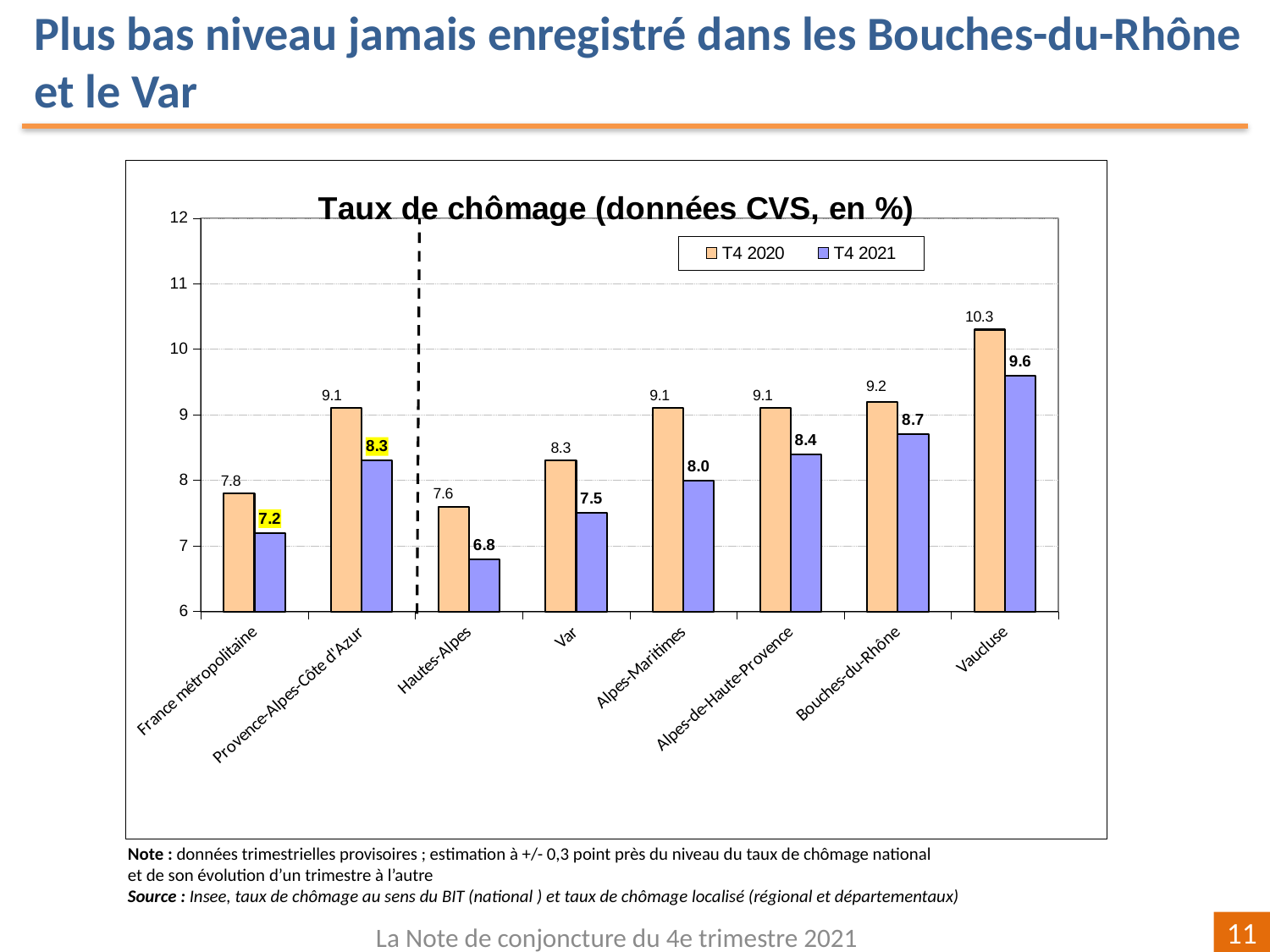
How many categories are shown on the x axis? 8 What is the difference between the T4 2020 and T4 2021 values for Alpes-Maritimes? 1.1 Which category has the lowest T4 2020 value? Hautes-Alpes Which category has the highest T4 2021 value? Vaucluse What is the T4 2020 unemployment rate for Vaucluse? 10.3 Which is larger, the T4 2021 value for Var or the T4 2021 value for France métropolitaine? Var What kind of chart is shown on the slide? bar chart How many series does the legend list? 2 What is the title of the chart? Taux de chômage (données CVS, en %) What is the T4 2021 value for Hautes-Alpes? 6.8 Is the T4 2021 value for Provence-Alpes-Côte d'Azur greater or less than 9? less What is the T4 2021 unemployment rate for Bouches-du-Rhône? 8.7